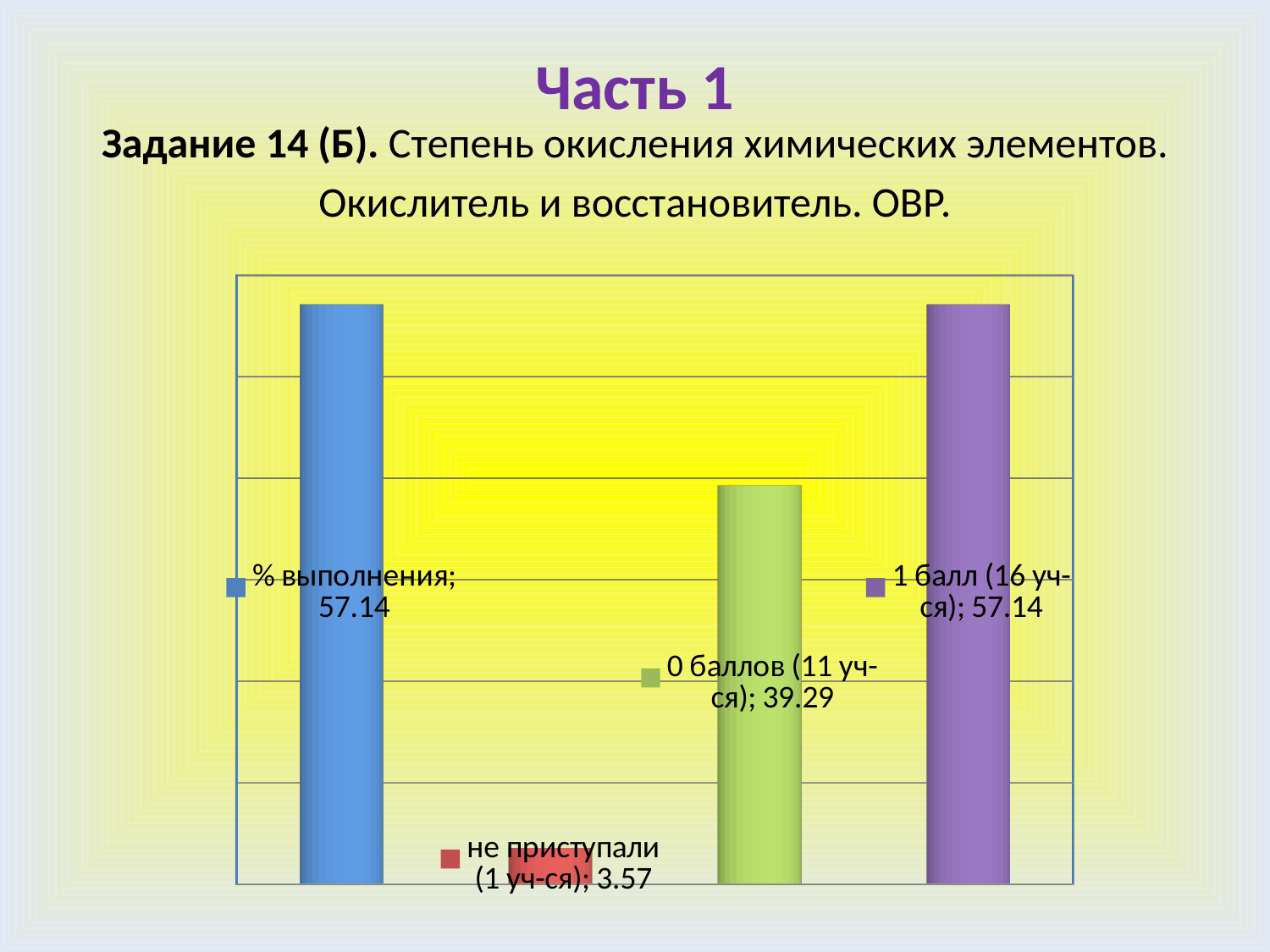
What is the difference between the values for "1 балл (16 уч-ся)" and "0 баллов (11 уч-ся)"? 17.85 How many bars are plotted in the chart? 4 Which category has the lowest value in the chart? не приступали (1 уч-ся) What is the value shown for "1 балл (16 уч-ся)"? 57.14 What kind of chart is shown on the slide? Bar chart What colour is the bar for "1 балл (16 уч-ся)"? Purple What is the value shown for "% выполнения"? 57.14 What is the difference between the values for "0 баллов (11 уч-ся)" and "не приступали (1 уч-ся)"? 35.72 What is the value shown for "0 баллов (11 уч-ся)"? 39.29 What is the value shown for "не приступали (1 уч-ся)"? 3.57 Which is larger: the value for "% выполнения" or the value for "0 баллов (11 уч-ся)"? % выполнения Which is larger: the value for "0 баллов (11 уч-ся)" or the value for "не приступали (1 уч-ся)"? 0 баллов (11 уч-ся)